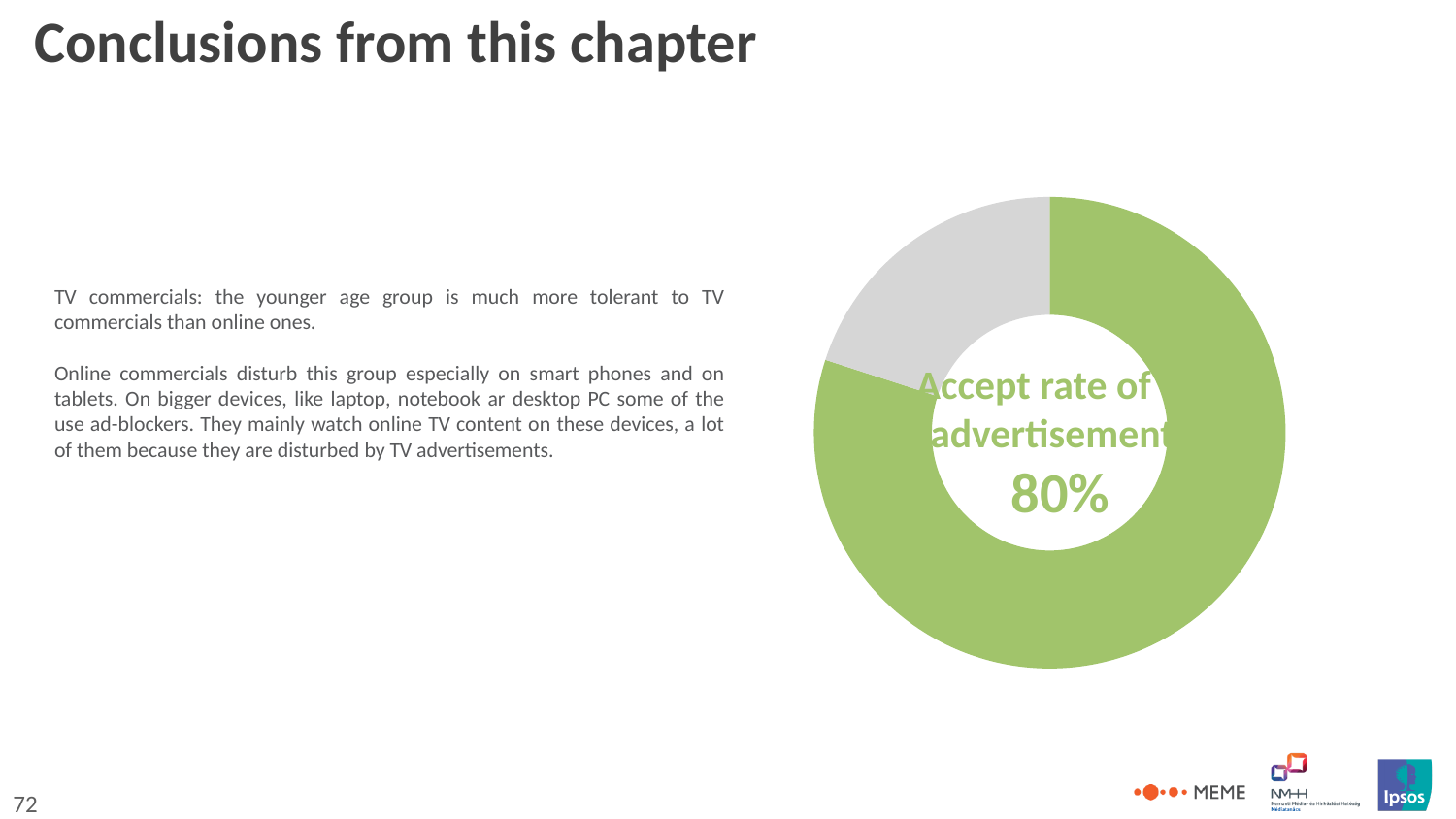
What share of the pie does the green slice represent? 80% Which slice is larger, the green one or the grey one? the green one Is the accept rate of advertisement greater or less than 50%? greater What colour is the largest slice of the chart? green What kind of chart is shown on the slide? pie chart (donut) How many slices does the pie chart have? 2 What is the accept rate of advertisement shown in the chart? 80% Is the grey slice greater or less than half of the pie? less What text is printed in the centre of the donut chart? Accept rate of advertisement 80%